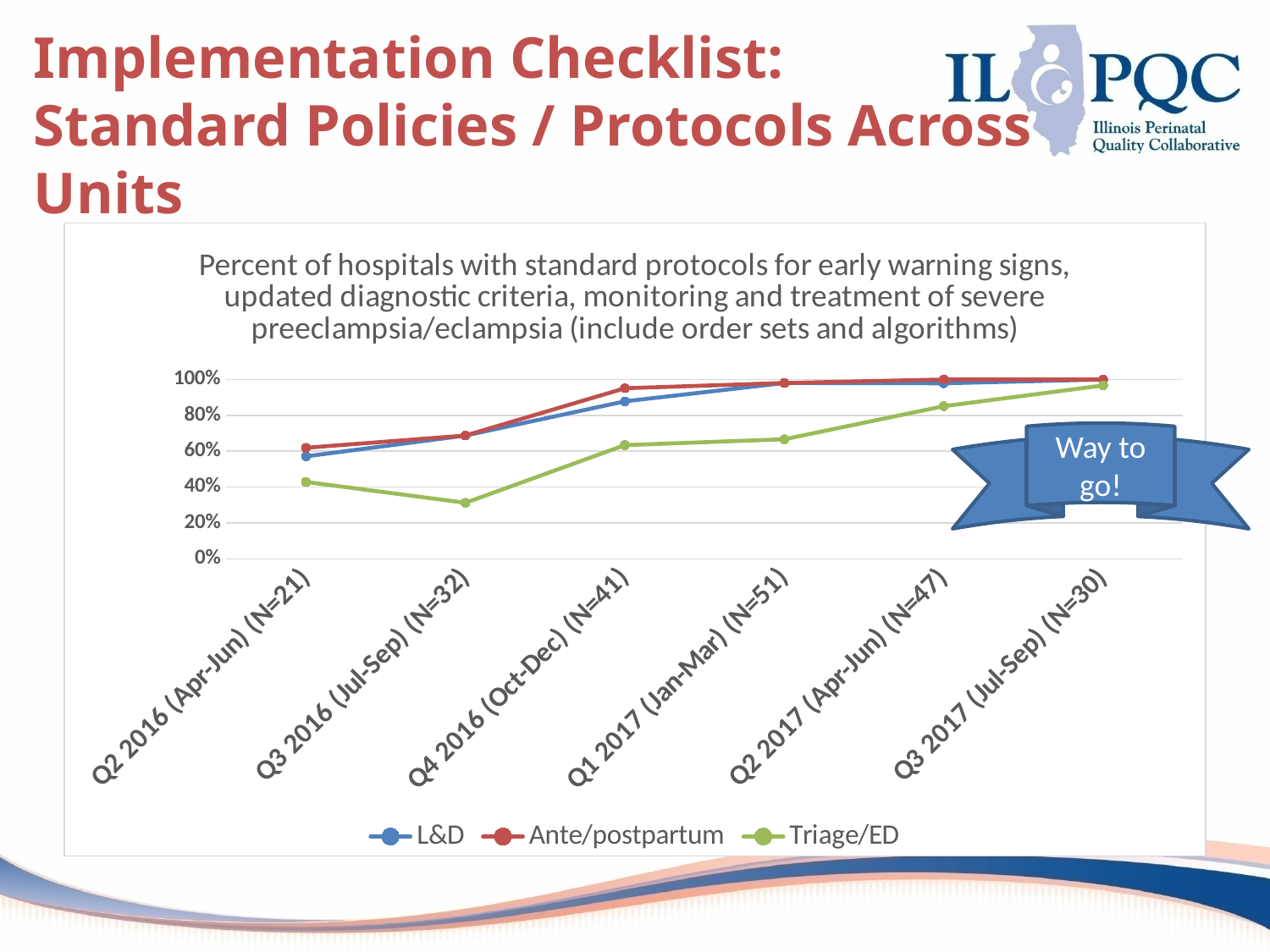
Which series is shown in green in the legend? Triage/ED Is the value for L&D in Q2 2016 (Apr-Jun) (N=21) greater or less than 60%? less Does the Triage/ED series rise or fall overall from Q2 2016 to Q3 2017? rise Is the value for Triage/ED in Q4 2016 (Oct-Dec) (N=41) greater or less than 60%? greater Is the value for Triage/ED in Q3 2016 (Jul-Sep) (N=32) greater or less than 40%? less What kind of chart is shown on the slide? line chart In Q2 2016 (Apr-Jun) (N=21), which is larger: the L&D value or the Triage/ED value? L&D How many quarters are plotted along the x axis? 6 In which quarter is the Triage/ED series at its lowest? Q3 2016 (Jul-Sep) (N=32) How many series does the legend list? 3